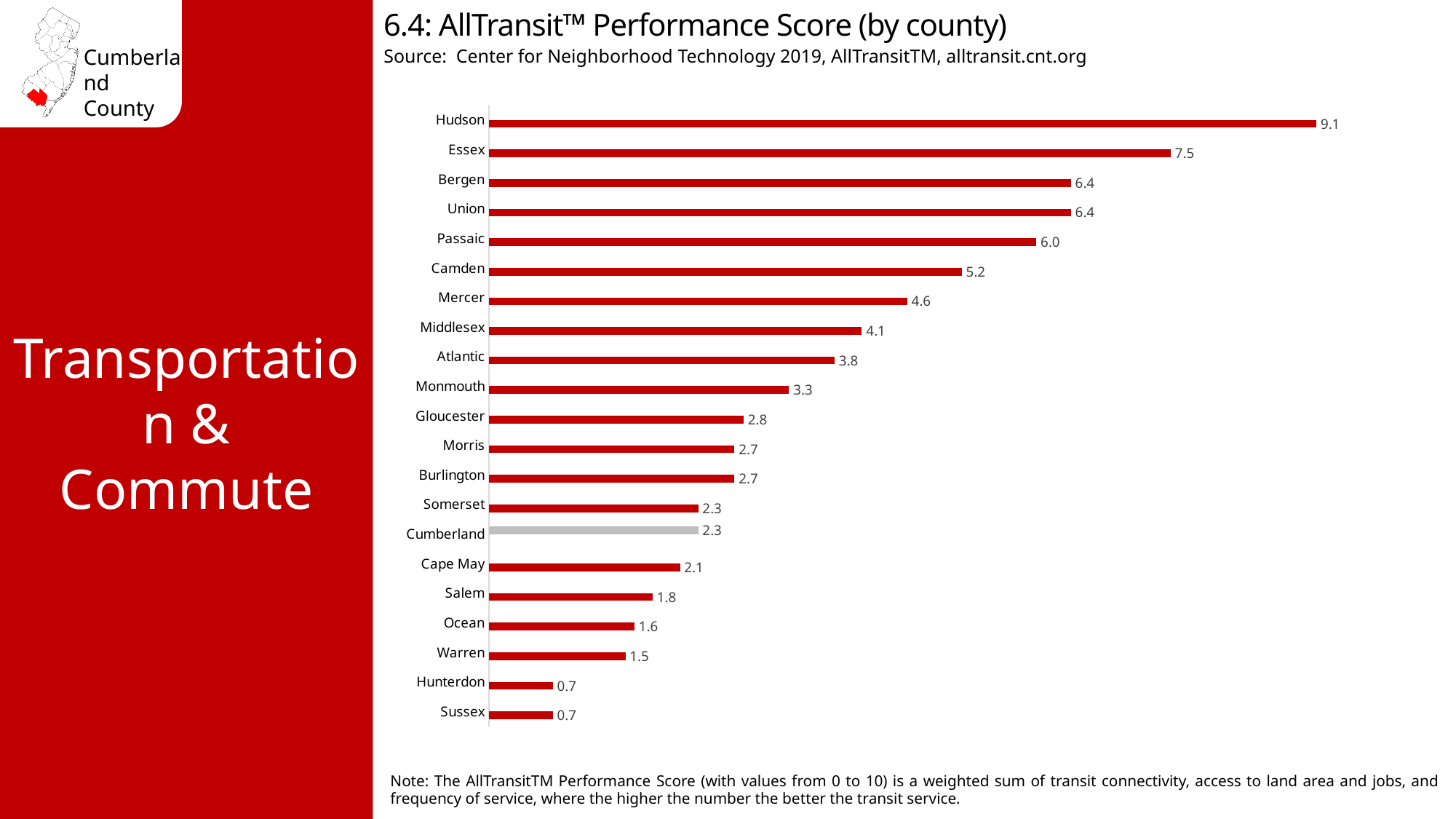
What is the difference between the AllTransit Performance Scores of Hudson and Essex? 1.6 Which county's bar is shown in grey rather than red? Cumberland What is the AllTransit Performance Score for Hudson County? 9.1 What is the difference between the AllTransit Performance Scores of Cumberland and Cape May? 0.2 Which county has a higher AllTransit Performance Score, Salem or Ocean? Salem What type of chart is used to show the AllTransit Performance Score by county? Bar chart Which county has the highest AllTransit Performance Score? Hudson What is the AllTransit Performance Score for Camden County? 5.2 Which county has a higher AllTransit Performance Score, Mercer or Middlesex? Mercer What is the lowest AllTransit Performance Score shown on the chart? 0.7 What is the AllTransit Performance Score for Cumberland County? 2.3 How many counties are shown on the chart? 21